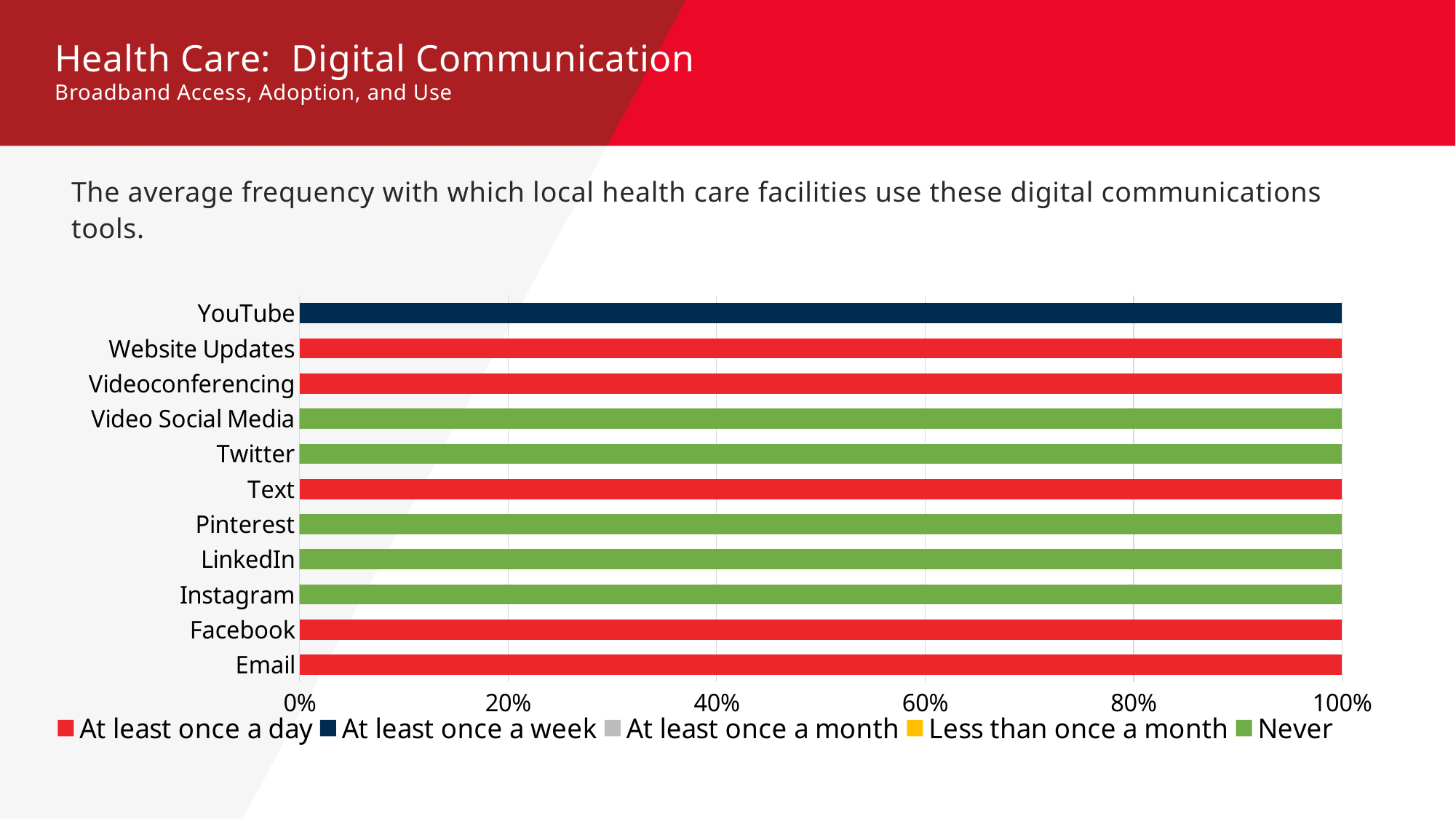
How many digital communication tools (categories) are listed on the chart? 11 What kind of chart is shown on the slide? bar chart How many tools have a bar made up entirely of the "Never" category? 5 Which frequency category makes up the entire YouTube bar? At least once a week How many series does the chart legend list? 5 What is the value of "Never" for Pinterest? 100% Which frequency category makes up the entire Email bar? At least once a day What colour represents "Never" in the legend? green What is the total of the stacked bar for Instagram? 100% What is the value of "At least once a day" for Facebook? 100% Is the value of "Never" for LinkedIn greater or less than 80%? greater Which frequency category makes up the entire Twitter bar? Never